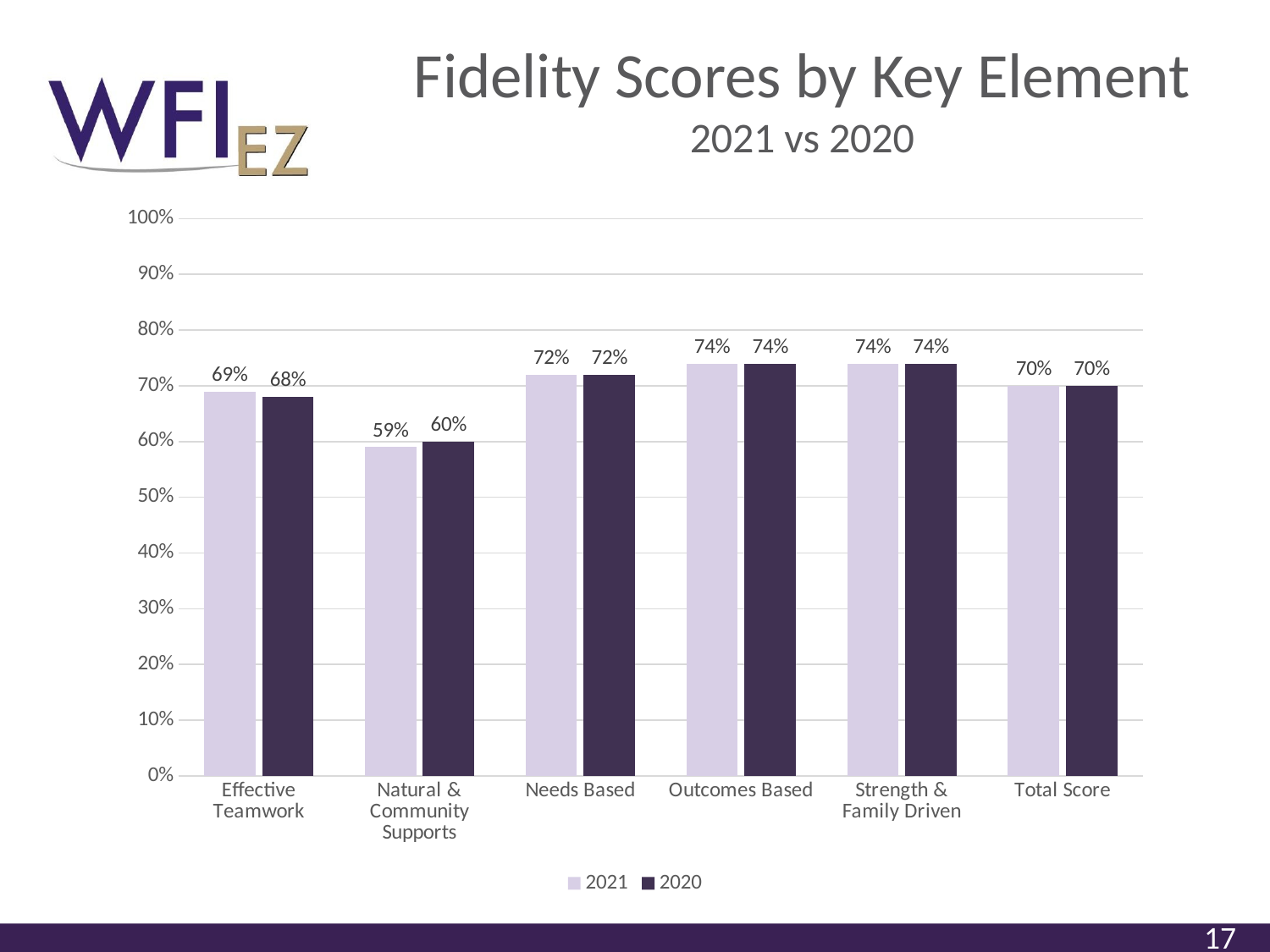
Which category has the lowest 2021 value? Natural & Community Supports Is the 2020 value for Strength & Family Driven greater or less than 70%? greater What is the 2020 value for Natural & Community Supports? 60% What is the 2021 value for Total Score? 70% What is the difference between the 2021 and 2020 values for Effective Teamwork? 1% How many series does the legend list? 2 Which is larger, the 2021 value for Needs Based or the 2021 value for Natural & Community Supports? Needs Based What kind of chart is shown on the slide? bar chart How many categories are shown on the x axis? 6 What is the difference between the 2021 values for Outcomes Based and Natural & Community Supports? 15% What is the title of the chart? Fidelity Scores by Key Element 2021 vs 2020 What is the 2021 value for Effective Teamwork? 69%